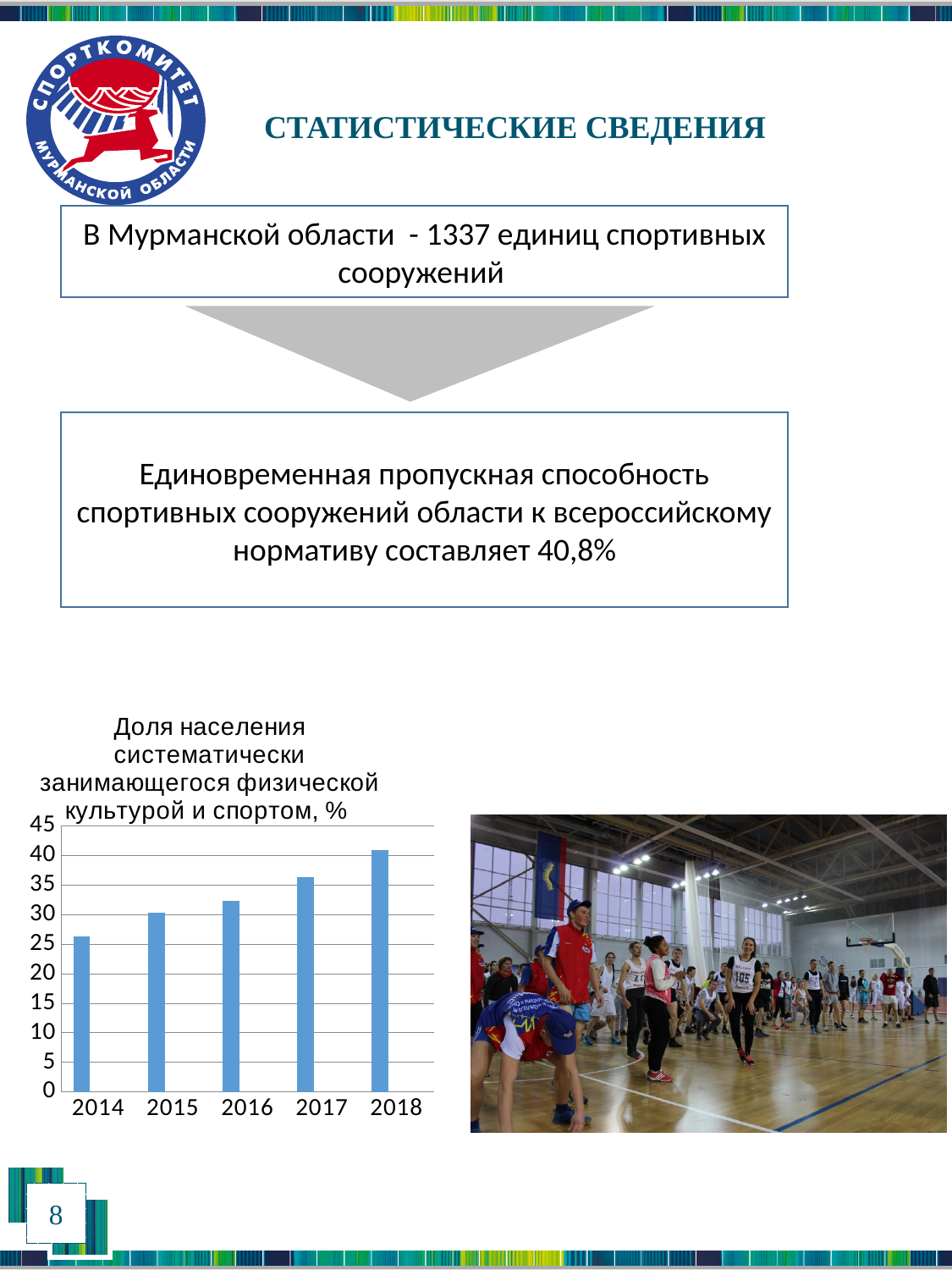
Is the value for 2016 greater or less than 30? greater How many years are shown on the x axis of the chart? 5 Do the values in the chart rise or fall from 2014 to 2018? rise What kind of chart is shown on the slide? bar chart Which year has the lowest value in the chart? 2014 Is the value for 2014 greater or less than 30? less Which is larger, the value for 2015 or the value for 2017? 2017 Which year has the highest value in the chart? 2018 What is the title of the chart? Доля населения систематически занимающегося физической культурой и спортом, % Is the value for 2018 greater or less than 35? greater Which is larger, the value for 2014 or the value for 2018? 2018